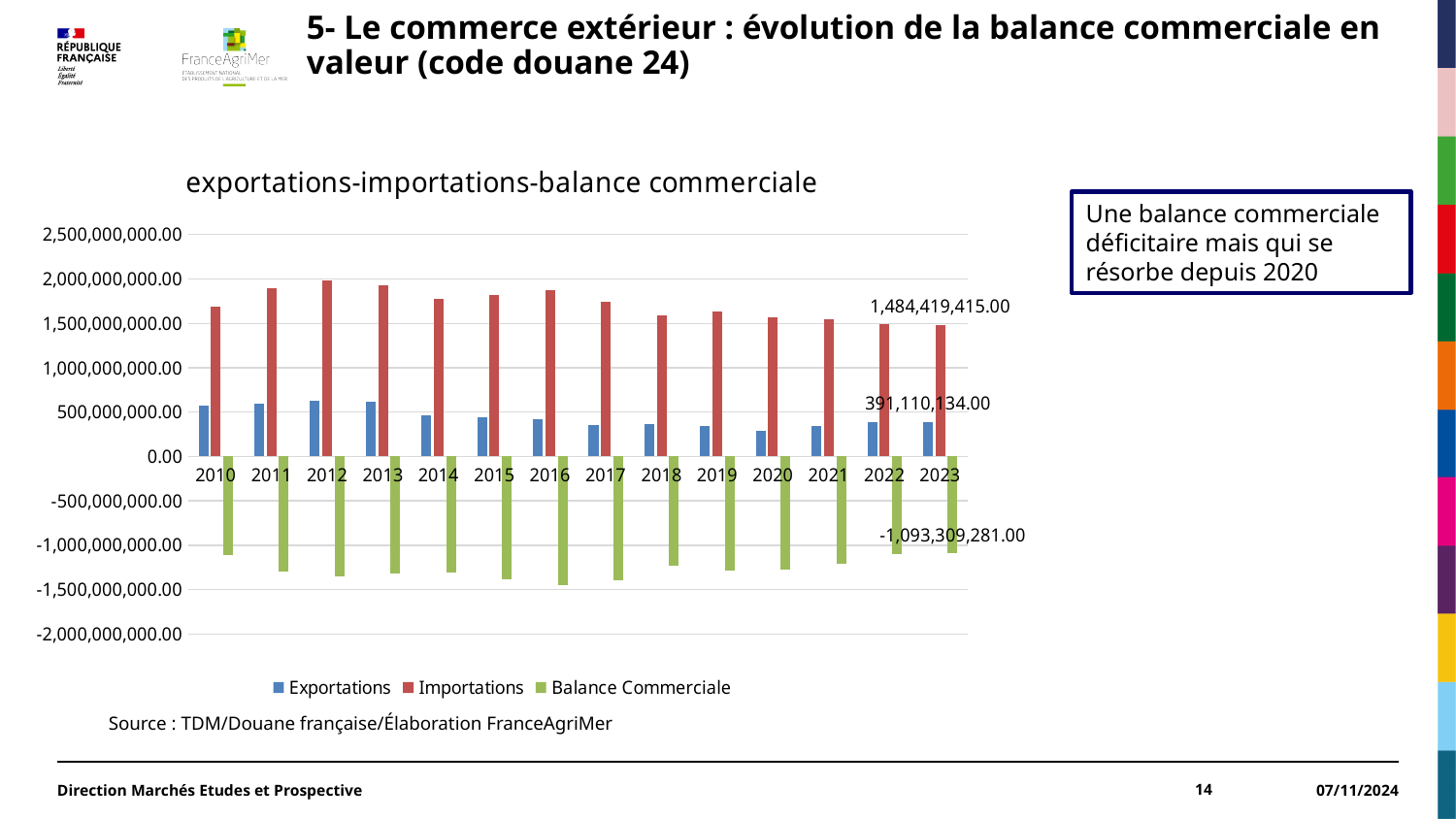
What is the value of Exportations for 2023? 391,110,134.00 Is the Exportations value for 2020 greater or less than 500,000,000.00? less In which year is the Exportations value lowest? 2020 What is the value of Balance Commerciale for 2023? -1,093,309,281.00 What is the value of Importations for 2023? 1,484,419,415.00 Which year has the larger Importations value, 2011 or 2021? 2011 What kind of chart is shown? bar chart How many series does the legend list? 3 What is the difference between Importations and Exportations in 2023? 1,093,309,281.00 How many years are shown on the x axis? 14 Do the Importations values rise or fall from 2016 to 2023? fall Is the Importations value for 2010 greater or less than 1,500,000,000.00? greater